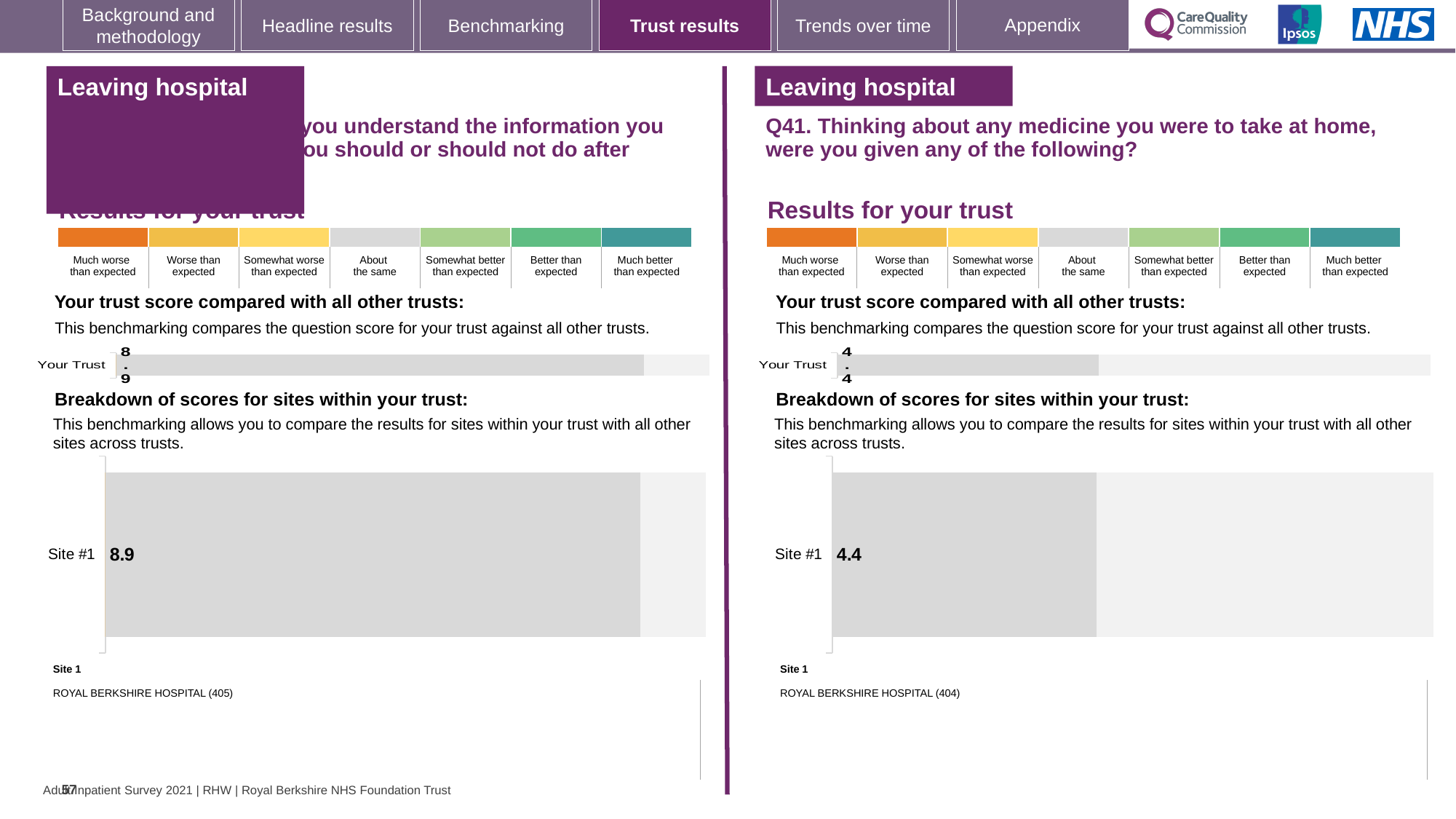
How many sites are shown in the right (Q41) 'Breakdown of scores for sites within your trust' chart? 1 On the left half of the slide, what is the score shown for Your Trust in the 'Your trust score compared with all other trusts' chart? 8.9 What type of chart is used to show the Site #1 score on the right half of the slide? Bar chart On the right half of the slide (Q41), what is the score shown for Your Trust in the 'Your trust score compared with all other trusts' chart? 4.4 What is the difference between the Site #1 score on the left chart and the Site #1 score on the right (Q41) chart? 4.5 In the right (Q41) 'Breakdown of scores for sites within your trust' chart, what is the score for Site #1? 4.4 Which site is listed as Site 1 below the left breakdown chart? ROYAL BERKSHIRE HOSPITAL (405) Which site is listed as Site 1 below the right (Q41) breakdown chart? ROYAL BERKSHIRE HOSPITAL (404) How many sites are shown in the left 'Breakdown of scores for sites within your trust' chart? 1 In the left 'Breakdown of scores for sites within your trust' chart, what is the score for Site #1? 8.9 Which is larger: the Your Trust score on the left half of the slide or the Your Trust score on the right half (Q41)? Left half (8.9)